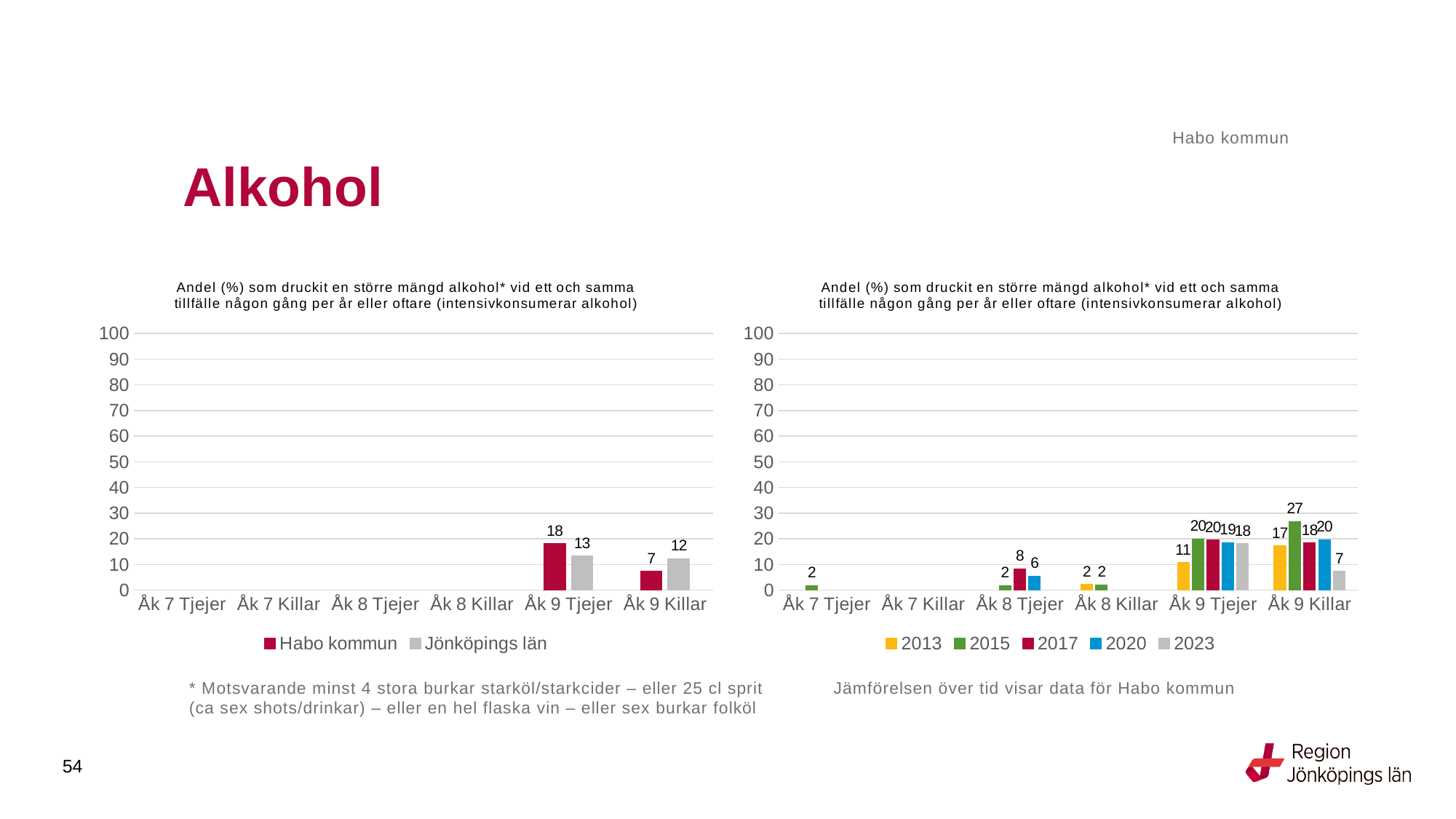
In the right chart, what is the value for 2023 for Åk 9 Killar? 7 In the right chart, what is the value for 2015 for Åk 9 Killar? 27 What kind of chart is the right chart? Bar chart In the right chart, what is the difference between the 2015 and 2023 values for Åk 9 Killar? 20 How many series does the legend of the right chart list? 5 In the left chart, which is larger for Åk 9 Killar: Habo kommun or Jönköpings län? Jönköpings län In the left chart, what is the value for Habo kommun for Åk 9 Tjejer? 18 In the right chart, which year has the highest value for Åk 9 Killar? 2015 In the right chart, what is the value for 2013 for Åk 9 Tjejer? 11 In the left chart, what is the value for Jönköpings län for Åk 9 Killar? 12 In the left chart, what is the difference between Habo kommun and Jönköpings län for Åk 9 Tjejer? 5 How many series does the legend of the left chart list? 2